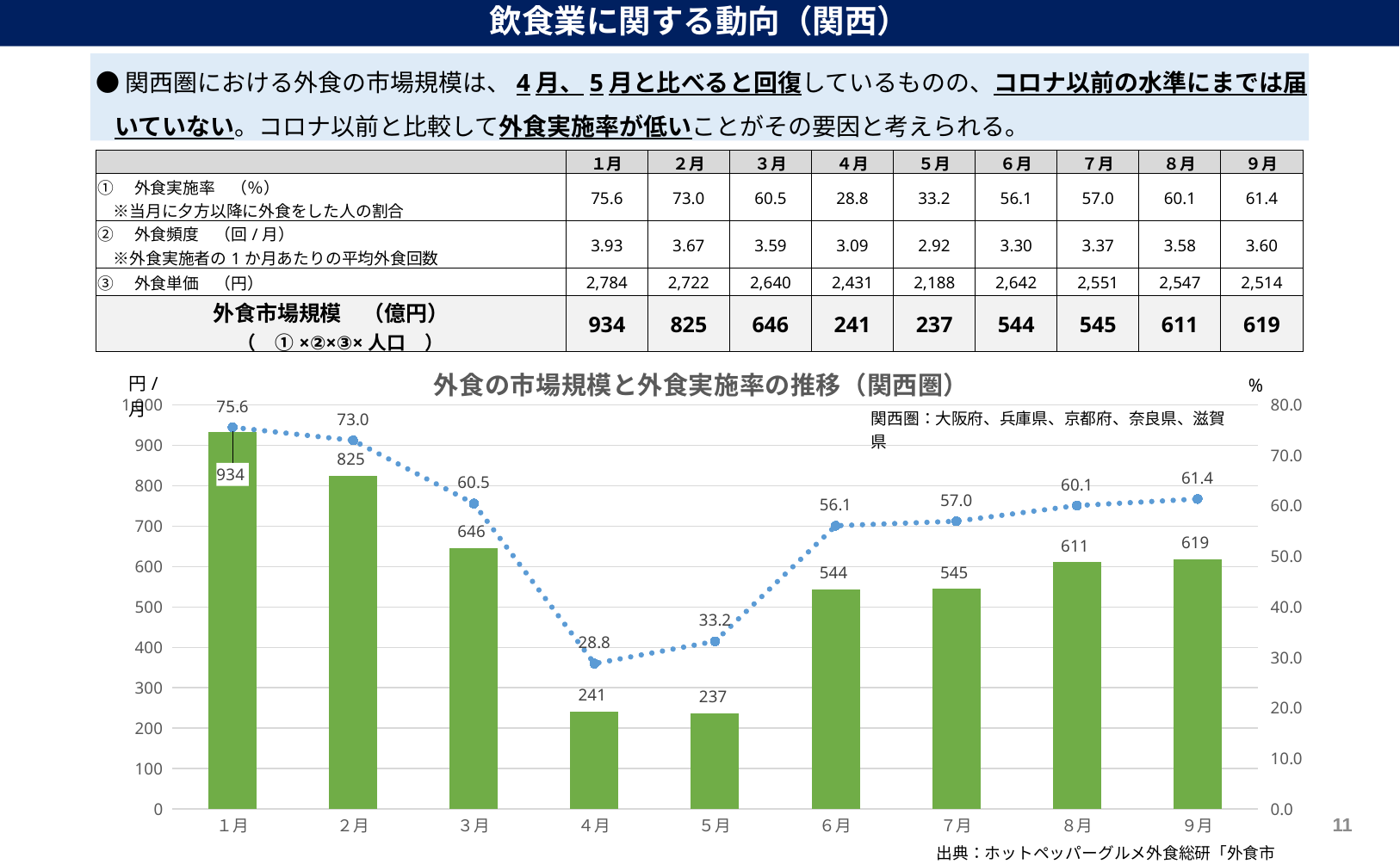
What is the difference between the line values for 9月 and 8月? 1.3 What is the title of the chart? 外食の市場規模と外食実施率の推移（関西圏） Which is larger, the bar value for 8月 or the bar value for 6月? 8月 What kind of chart is shown on the slide? Combined bar and line chart How many months are plotted on the x axis of the chart? 9 What is the difference between the bar values for 1月 and 5月? 697 What is the bar value for 9月 in the chart? 619 Which month has the lowest bar value in the chart? 5月 Do the bar values rise or fall from 1月 to 4月? Fall What is the 外食実施率 (line) value for 4月 in the chart? 28.8 What is the market size (bar) value for 1月 in the chart? 934 Which month has the highest 外食実施率 (line) value in the chart? 1月